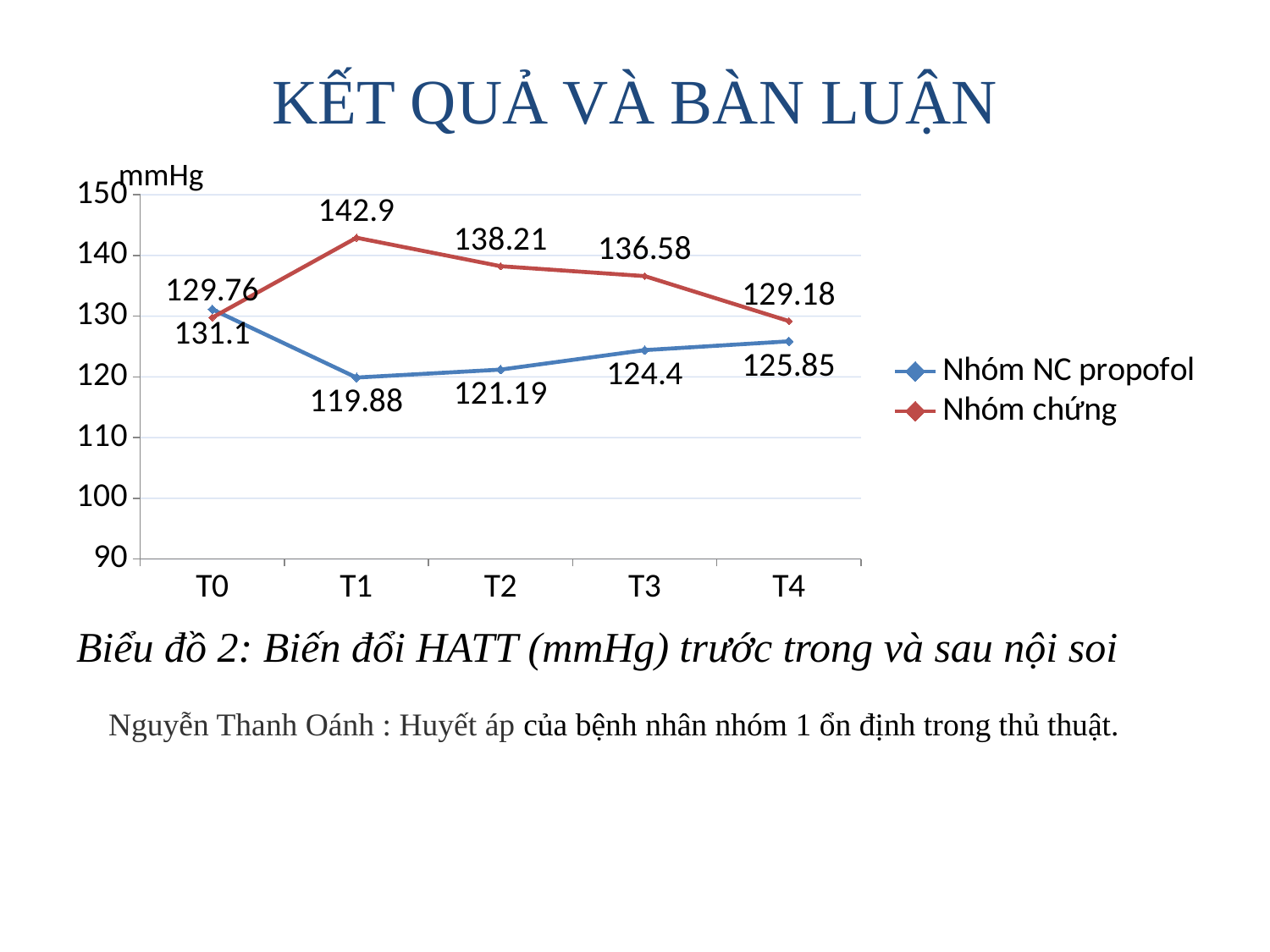
What is the value for Nhóm chứng at T1? 142.9 At which time point is the Nhóm NC propofol series lowest? T1 What is the value for Nhóm chứng at T4? 129.18 How many time points are shown on the x axis? 5 Does the Nhóm NC propofol series rise or fall from T1 to T4? Rise What is the value for Nhóm NC propofol at T3? 124.4 At which time point is the Nhóm chứng series highest? T1 What is the value for Nhóm NC propofol at T1? 119.88 Which series has the larger value at T2, Nhóm NC propofol or Nhóm chứng? Nhóm chứng What is the difference between Nhóm chứng and Nhóm NC propofol at T1? 23.02 How many series does the legend list? 2 What kind of chart is shown on the slide? Line chart